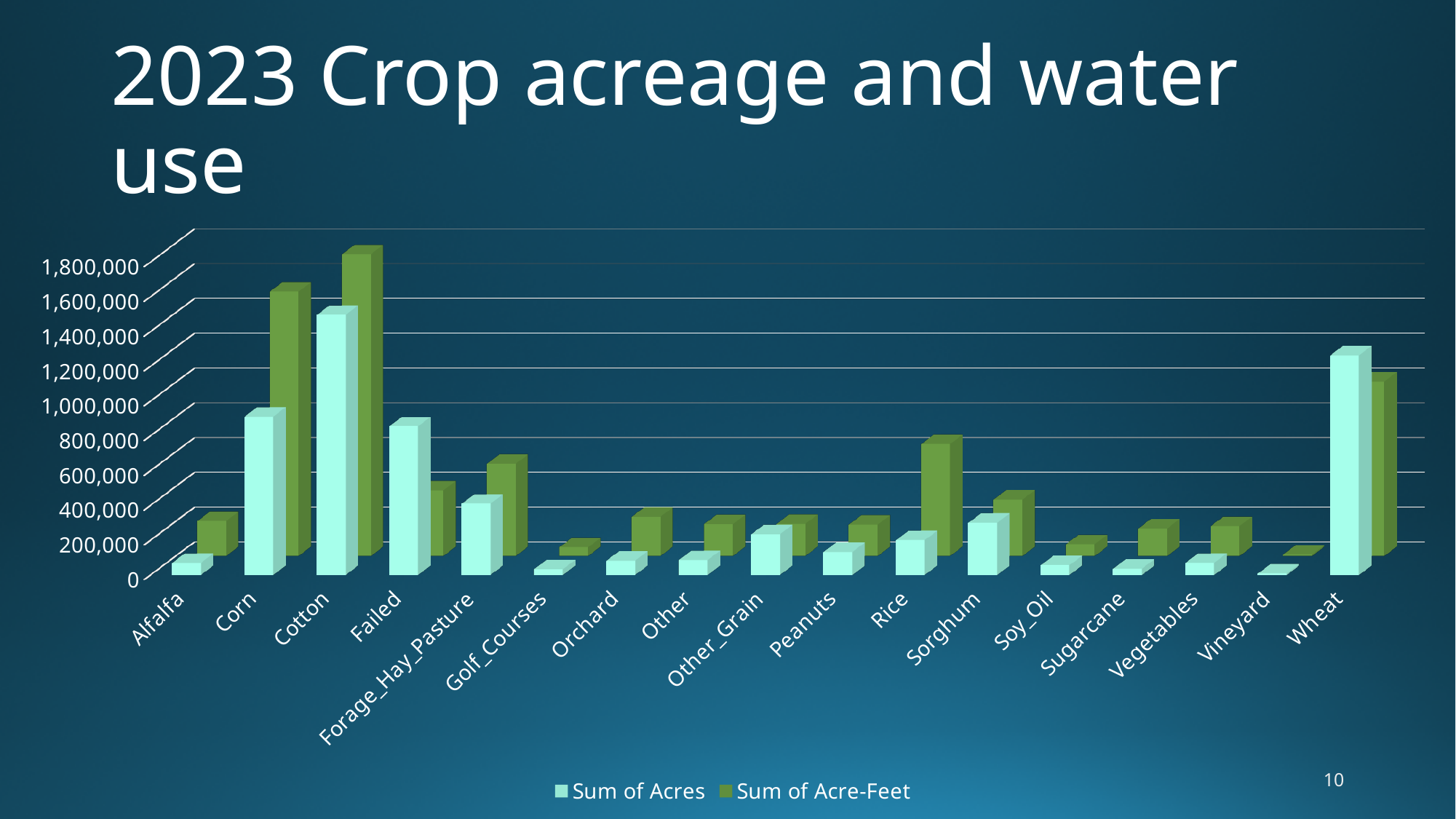
Is the Sum of Acres for Alfalfa greater or less than 200,000? less Which category has the lowest Sum of Acres? Vineyard What kind of chart is shown on the slide? Bar chart Which is larger, the Sum of Acre-Feet for Rice or the Sum of Acre-Feet for Sorghum? Rice Which category has the highest Sum of Acres? Cotton Is the Sum of Acre-Feet for Corn greater or less than 1,400,000? greater How many series does the legend list? 2 Is the Sum of Acre-Feet for Rice greater or less than 600,000? greater Which category has the highest Sum of Acre-Feet? Cotton How many crop categories are shown on the x axis? 17 Which is larger, the Sum of Acres for Corn or the Sum of Acres for Failed? Corn